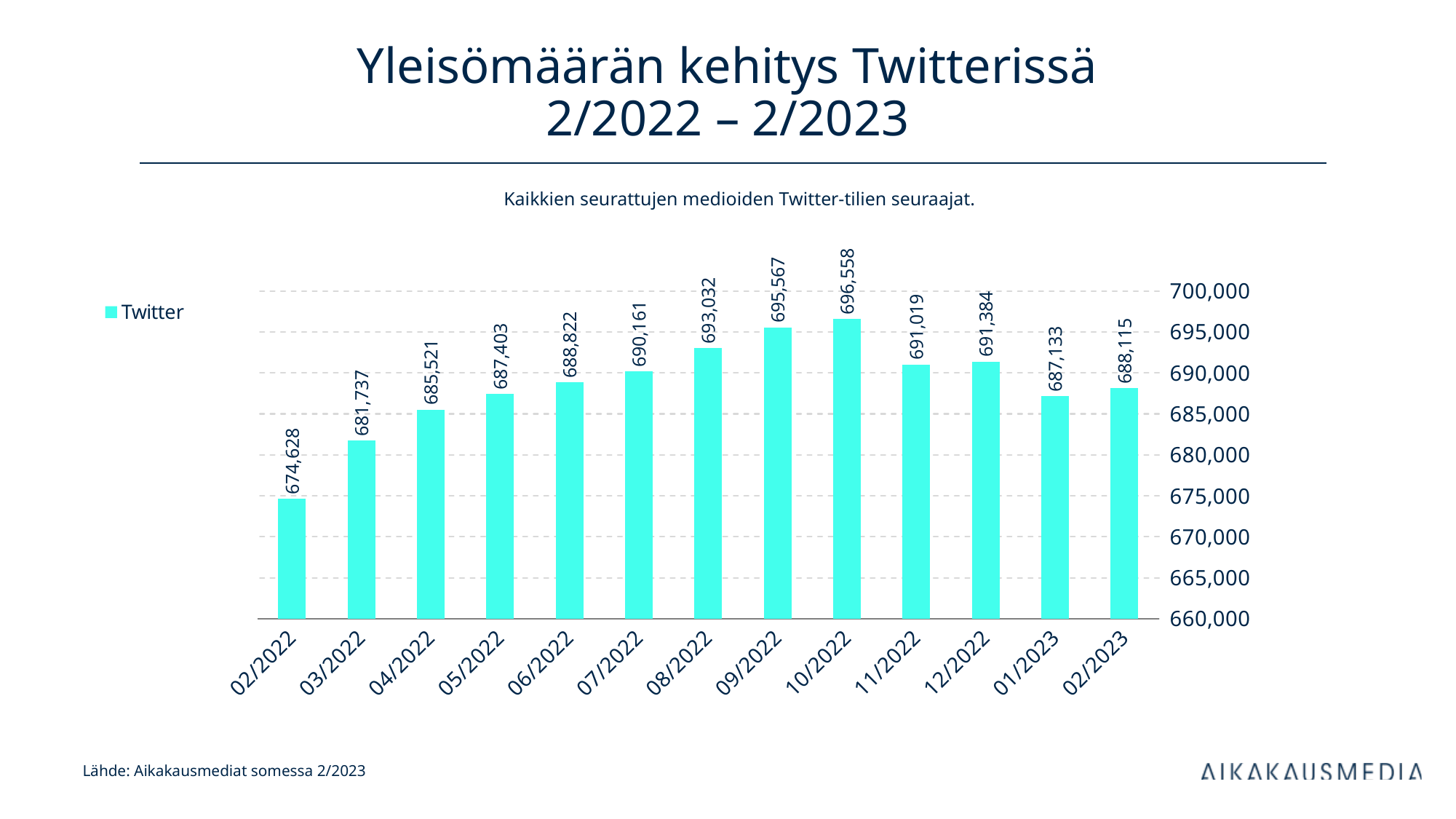
Do the values rise or fall from 02/2022 to 10/2022? rise Which month has the lowest value? 02/2022 Which is larger, the value for 09/2022 or the value for 11/2022? 09/2022 Is the value for 03/2022 greater or less than 685,000? less What is the difference between the values for 10/2022 and 02/2022? 21,930 What is the difference between the values for 02/2023 and 02/2022? 13,487 Which month has the highest value? 10/2022 What is the value for 02/2023? 688,115 What is the value for 02/2022? 674,628 What kind of chart is shown on the slide? bar chart What is the value for 10/2022? 696,558 How many months are shown on the x axis? 13